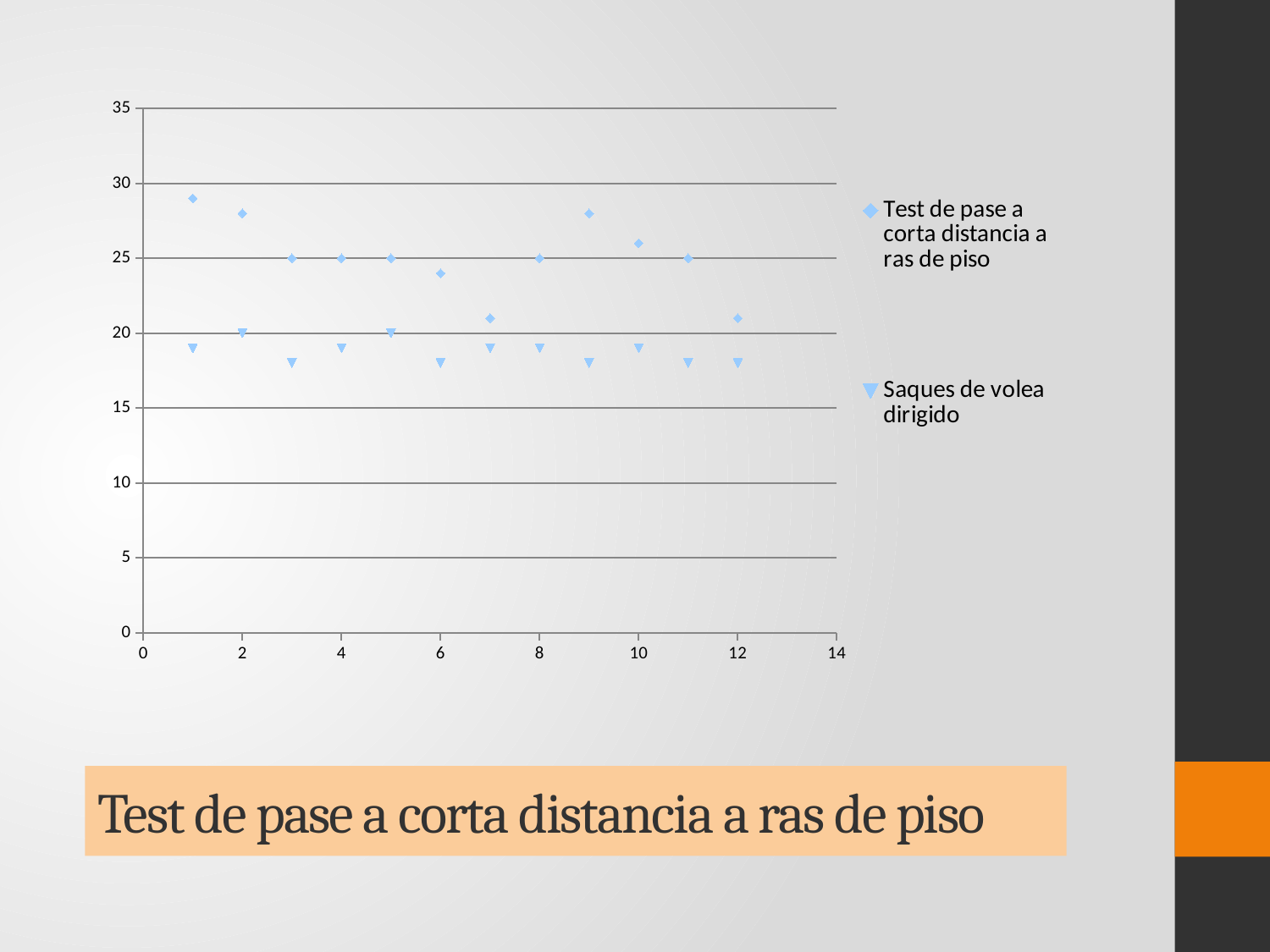
What kind of chart is shown on the slide? scatter chart Is the value of 'Test de pase a corta distancia a ras de piso' at x = 1 greater or less than 25? greater Is the value of 'Saques de volea dirigido' at x = 3 greater or less than 20? less For 'Test de pase a corta distancia a ras de piso', which is larger, the value at x = 1 or the value at x = 7? x = 1 What is the value of 'Saques de volea dirigido' at x = 5? 20 At x = 6, which series has the larger value, 'Test de pase a corta distancia a ras de piso' or 'Saques de volea dirigido'? Test de pase a corta distancia a ras de piso How many points are plotted for the series 'Test de pase a corta distancia a ras de piso'? 12 Is the value of 'Test de pase a corta distancia a ras de piso' at x = 7 greater or less than 25? less What is the name of the second series in the legend? Saques de volea dirigido How many series does the legend list? 2 What is the value of 'Test de pase a corta distancia a ras de piso' at x = 3? 25 What is the value of 'Test de pase a corta distancia a ras de piso' at x = 8? 25